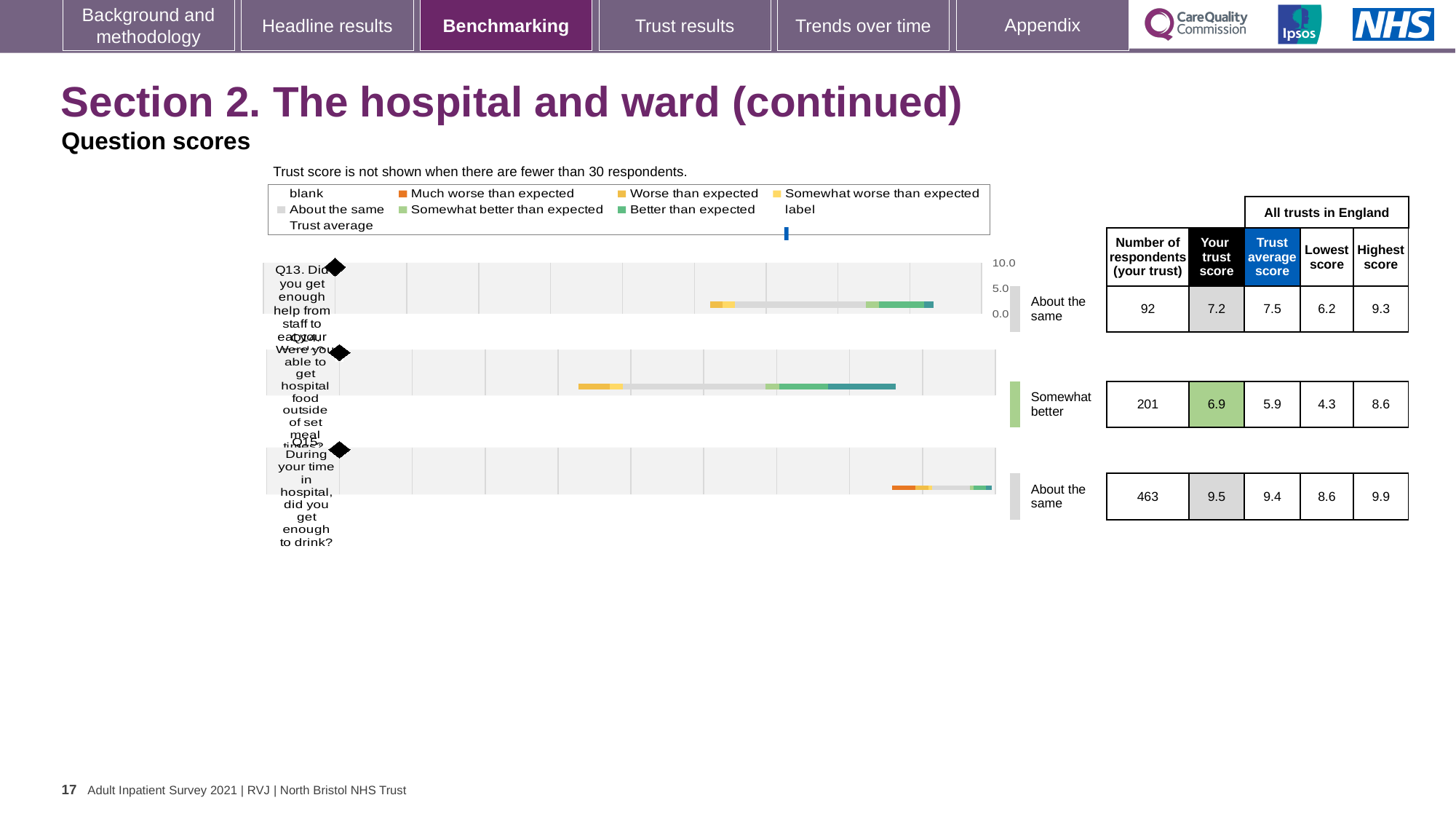
Which question has the highest 'Your trust score'? Q15 For Q13, which is larger: your trust score or the trust average score? Trust average score Which question has the lowest number of respondents for your trust? Q13 Which question is rated 'Somewhat better' than expected? Q14 What is the trust average score for Q14 (Were you able to get hospital food outside of set meal times?)? 5.9 How many respondents from your trust answered Q15 (did you get enough to drink?)? 463 What is the 'Your trust score' for Q13 (Did you get enough help from staff to eat your meals?)? 7.2 What kind of chart is used to show the question scores? Bar chart For Q14, what is the difference between your trust score and the trust average score? 1.0 What is the highest score across all trusts in England for Q15? 9.9 How many questions are plotted in the chart? 3 For Q15, what is the difference between the highest score and the lowest score across all trusts in England? 1.3